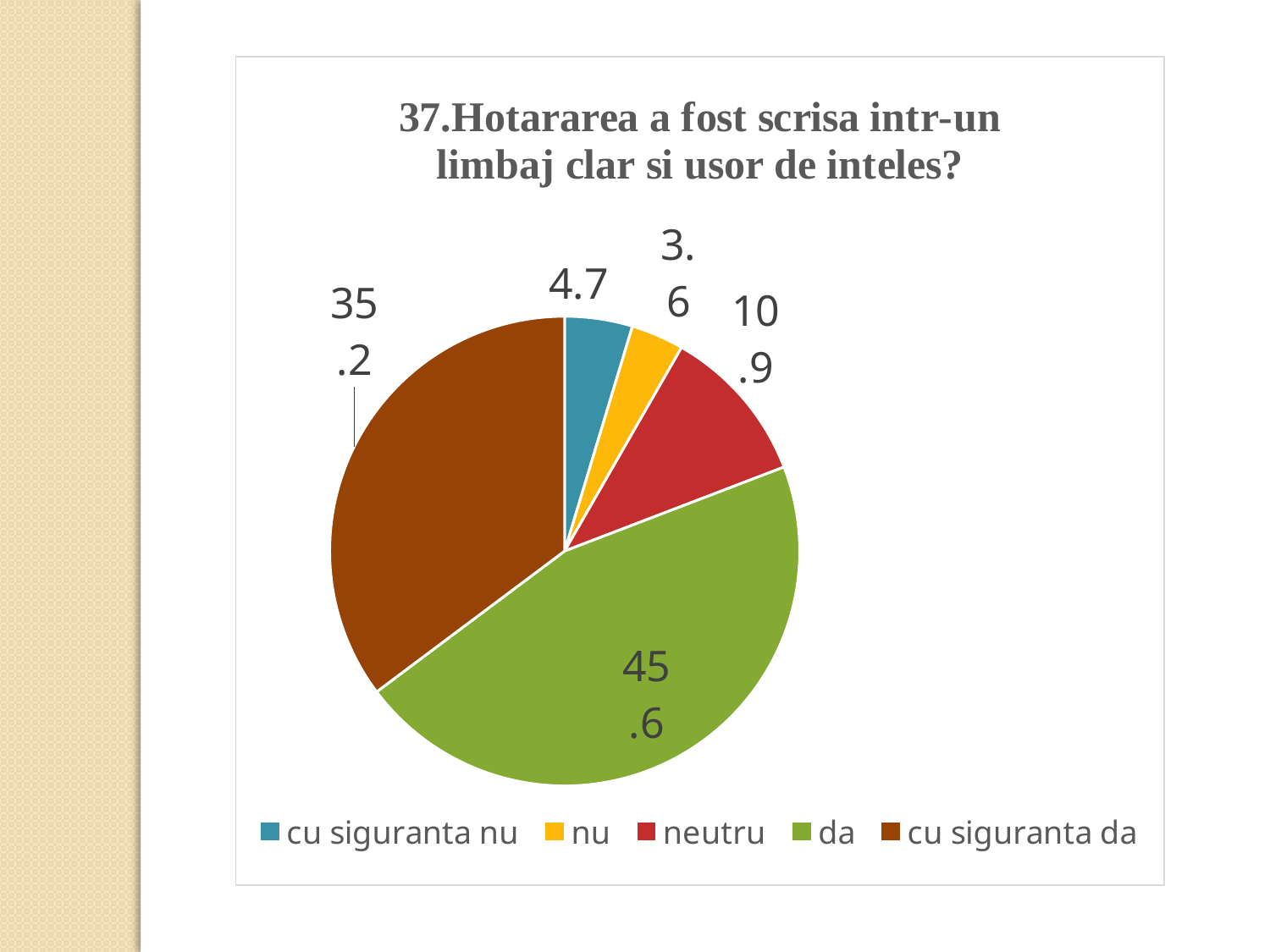
How many categories does the legend list? 5 What is the value for "da"? 45.6 What is the value for "nu"? 3.6 What is the value for "cu siguranta da"? 35.2 Which category has the largest slice? da What colour is the slice for "da"? green What is the value for "neutru"? 10.9 Which is larger, the value for "neutru" or the value for "cu siguranta nu"? neutru What is the value for "cu siguranta nu"? 4.7 Which category has the smallest slice? nu What kind of chart is shown on the slide? pie chart What is the difference between the values for "da" and "cu siguranta da"? 10.4